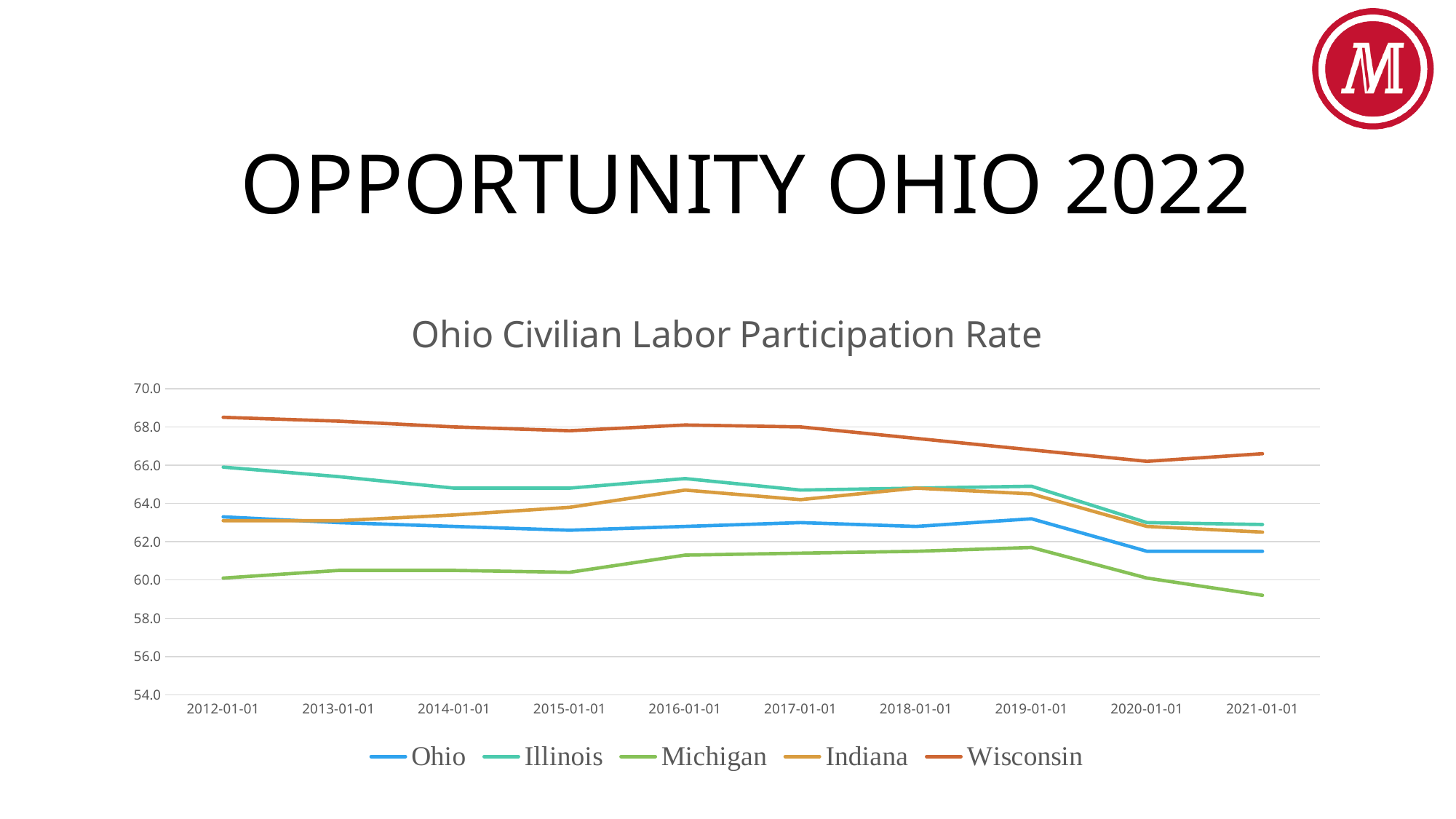
At 2019-01-01, which is higher, Indiana or Ohio? Indiana Is the value for Michigan at 2021-01-01 greater or less than 60.0? less Is the value for Wisconsin at 2012-01-01 greater or less than 68.0? greater Which state has the lowest labor participation rate at 2021-01-01? Michigan Is the value for Ohio at 2020-01-01 greater or less than 62.0? less What is the title of the chart? Ohio Civilian Labor Participation Rate What kind of chart is shown on the slide? line chart At 2012-01-01, which is higher, Illinois or Ohio? Illinois Which state has the highest labor participation rate at 2012-01-01? Wisconsin How many series does the legend list? 5 How many dates are shown along the x axis? 10 Does the Michigan line rise or fall from 2019-01-01 to 2021-01-01? fall